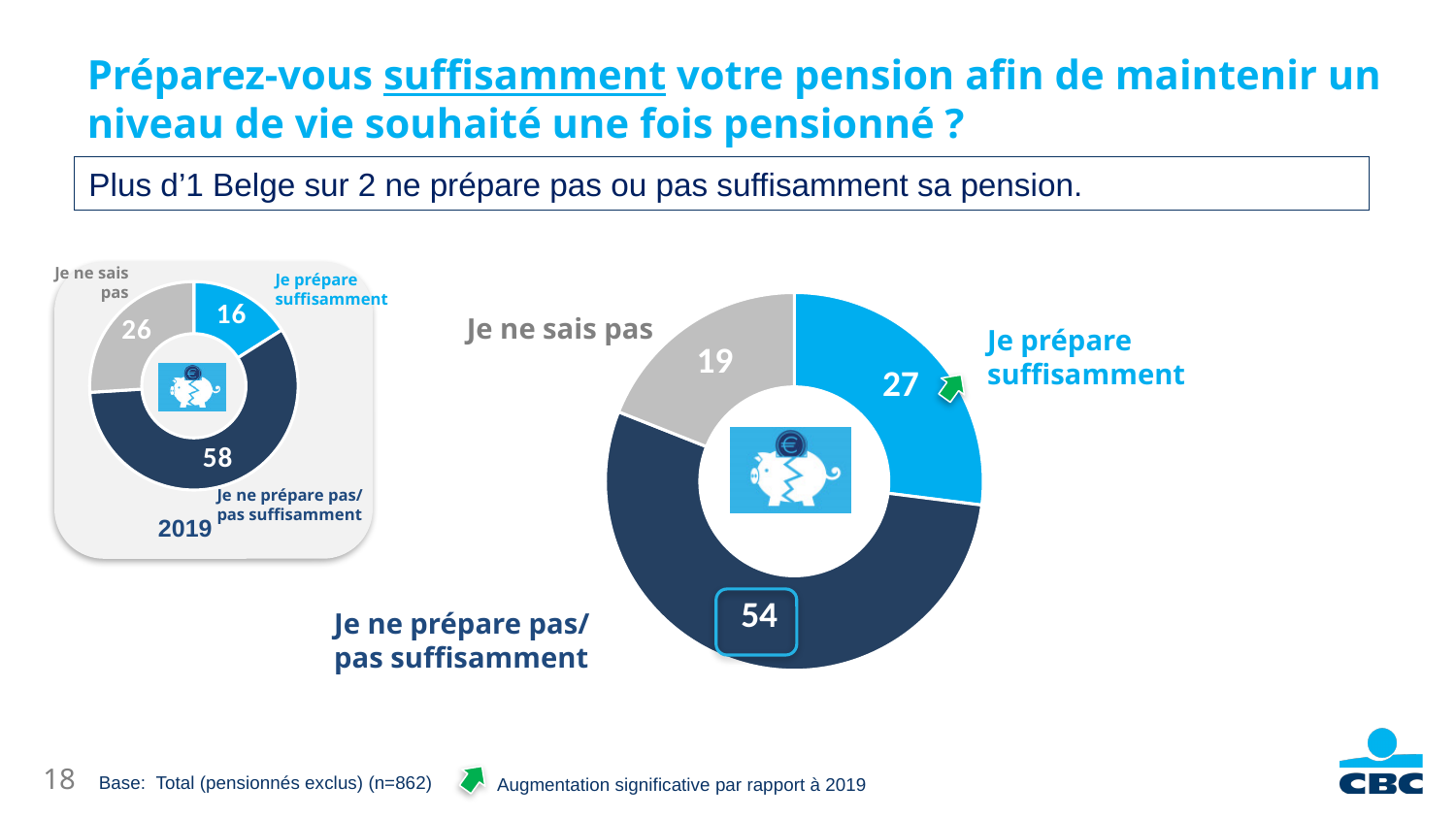
In the large donut chart on the right, which category has the largest value? Je ne prépare pas/ pas suffisamment What is the difference between the "Je prépare suffisamment" value in the large chart on the right (27) and in the small 2019 chart on the left (16)? 11 In the large donut chart on the right, which category has the smallest value? Je ne sais pas In the small 2019 donut chart on the left, what is the value for "Je ne prépare pas/ pas suffisamment"? 58 What type of chart is the large chart on the right? Donut (pie) chart In the large donut chart on the right, what is the value for "Je prépare suffisamment"? 27 In the large donut chart on the right, what is the value for "Je ne prépare pas/ pas suffisamment"? 54 In the large donut chart on the right, what is the value for "Je ne sais pas"? 19 How many categories does the large donut chart on the right show? 3 In the small 2019 donut chart on the left, what is the value for "Je ne sais pas"? 26 In the large donut chart on the right, which is larger: "Je prépare suffisamment" or "Je ne sais pas"? Je prépare suffisamment In the small 2019 donut chart on the left, what is the value for "Je prépare suffisamment"? 16